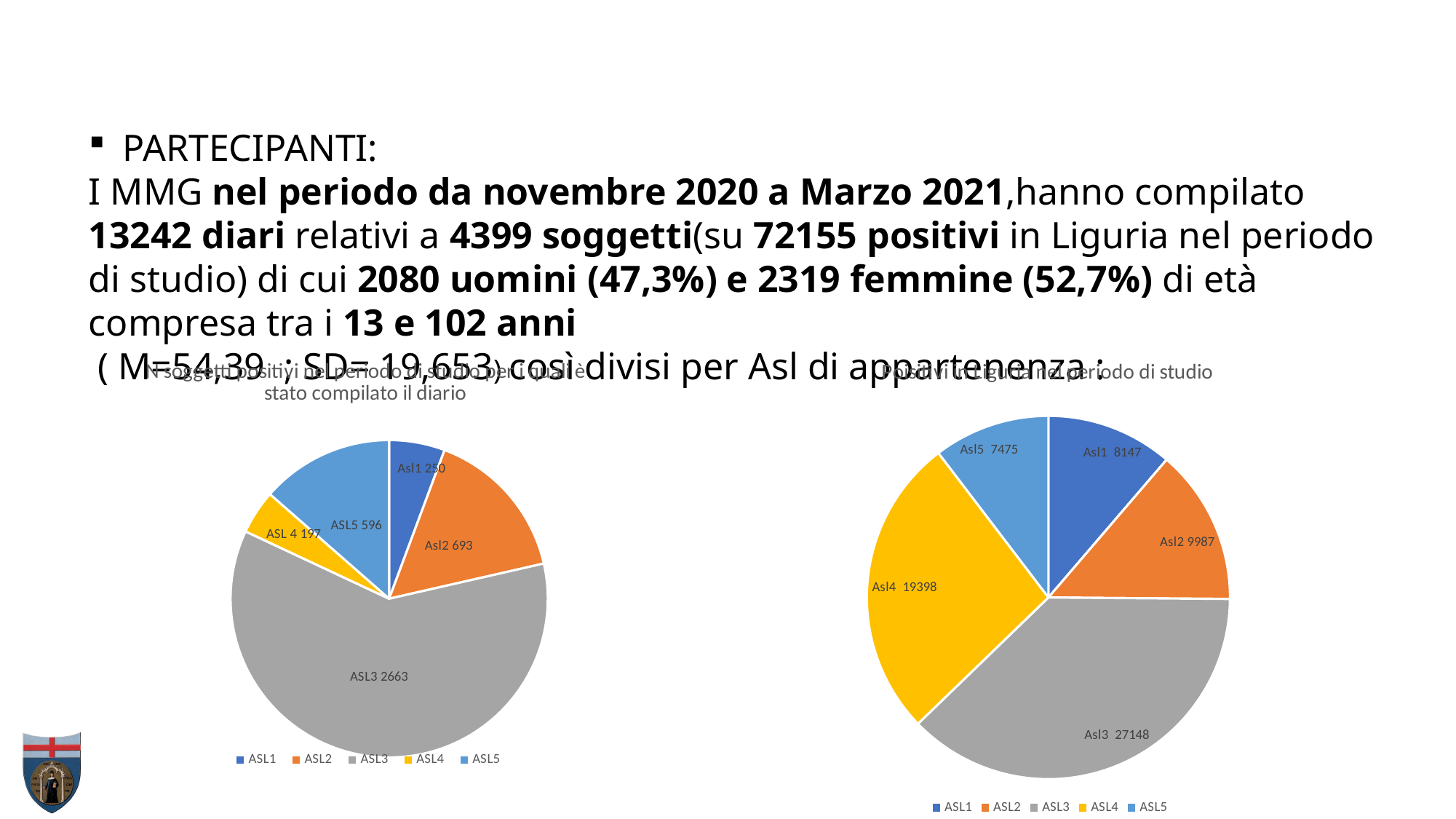
In the right pie chart, what is the value for Asl5? 7475 In the left pie chart, which is larger, the value for ASL2 or the value for ASL5? ASL2 In the right pie chart, what is the difference between the values for Asl3 and Asl4? 7750 In the left pie chart, what is the total of all five slices? 4399 How many slices does the right pie chart have? 5 In the right pie chart, which ASL has the smallest slice? ASL5 In the left pie chart, which ASL has the largest slice? ASL3 In the right pie chart, what is the value for Asl4? 19398 What type of chart is the left chart? Pie chart In the left pie chart, what is the value for ASL3? 2663 In the left pie chart, which ASL has the smallest slice? ASL4 In the left pie chart, what is the value for ASL4? 197